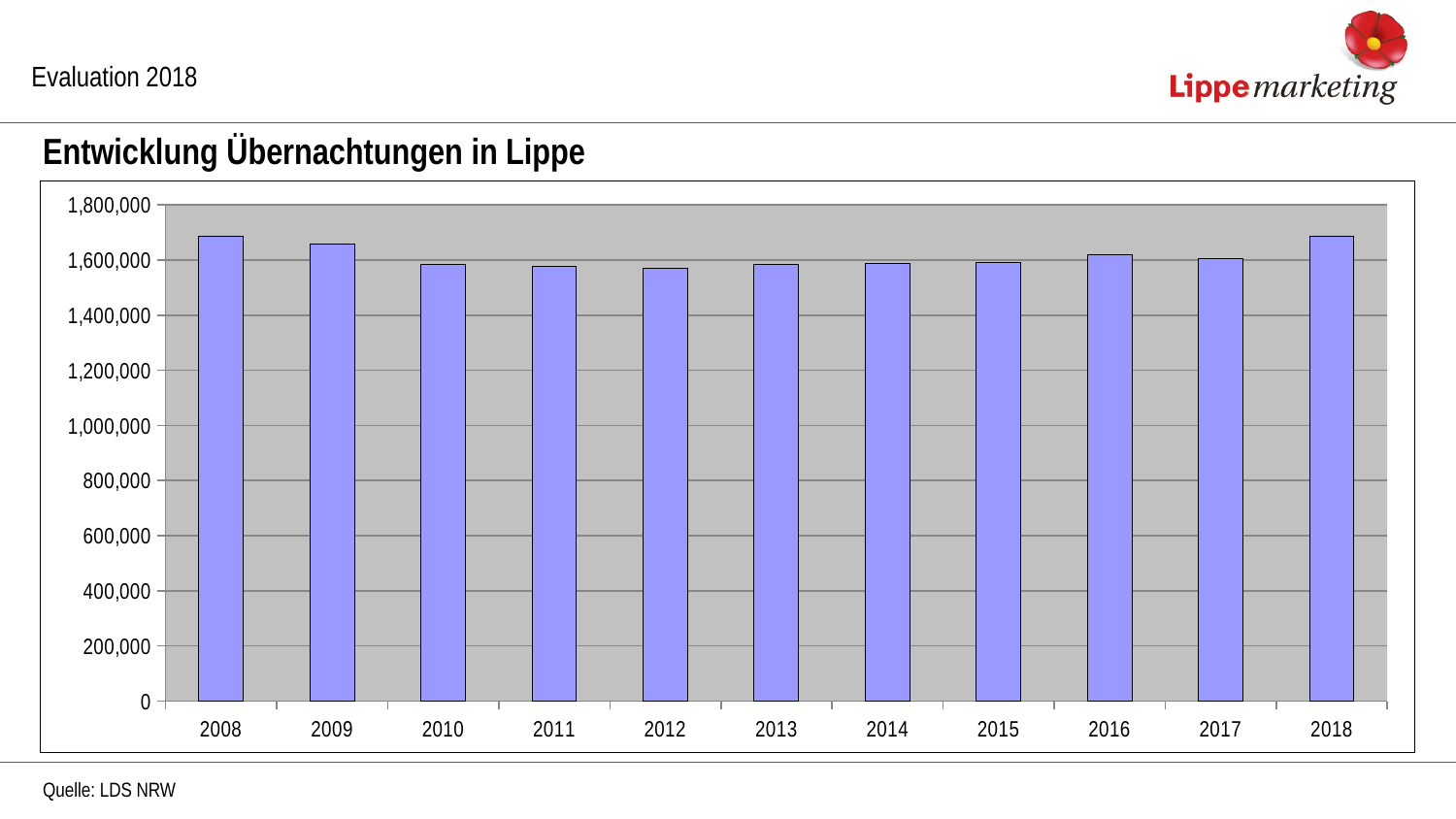
What kind of chart is shown on the slide? bar chart Is the value for 2008 greater or less than 1,600,000? greater Do the values rise or fall from 2017 to 2018? rise How many years are shown on the x axis of the chart? 11 What is the title of the chart? Entwicklung Übernachtungen in Lippe Do the values rise or fall from 2008 to 2010? fall Which year has the larger value, 2012 or 2016? 2016 Is the value for 2012 greater or less than 1,600,000? less Which year has the larger value, 2008 or 2010? 2008 Is the value for 2018 greater or less than 1,800,000? less What source is given for the chart data? LDS NRW